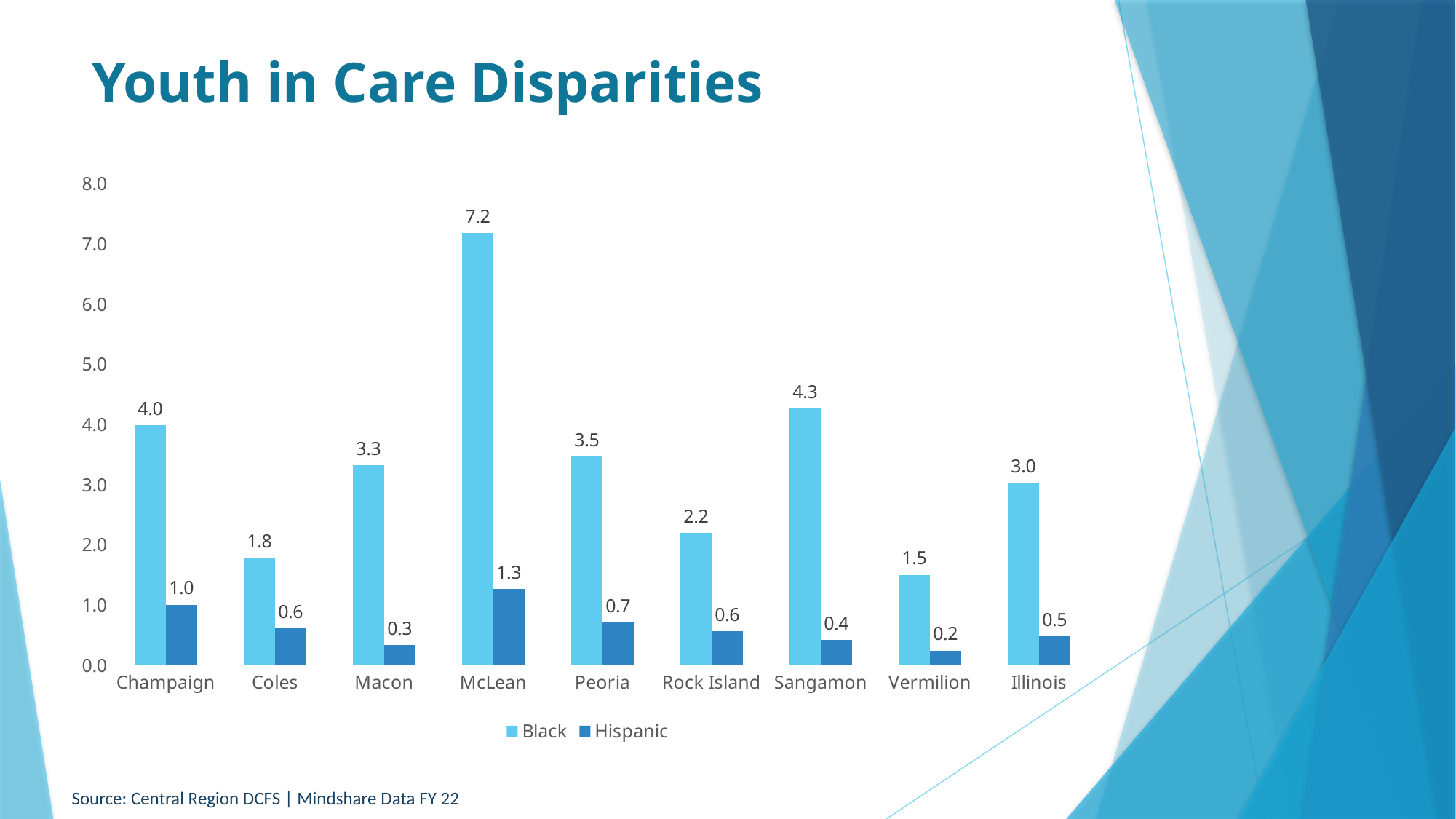
Which category has the highest Black value? McLean What is the Hispanic value for Champaign? 1.0 Which category has the lowest Hispanic value? Vermilion Which is larger, the Black value for Peoria or the Black value for Macon? Peoria What is the Hispanic value for Rock Island? 0.6 What kind of chart is shown on the slide? Bar chart What is the title of the slide? Youth in Care Disparities How many categories are shown on the x axis? 9 What is the Black value for Illinois? 3.0 What is the difference between the Black and Hispanic values for Sangamon? 3.9 What is the Black value for McLean? 7.2 How many series does the legend list? 2